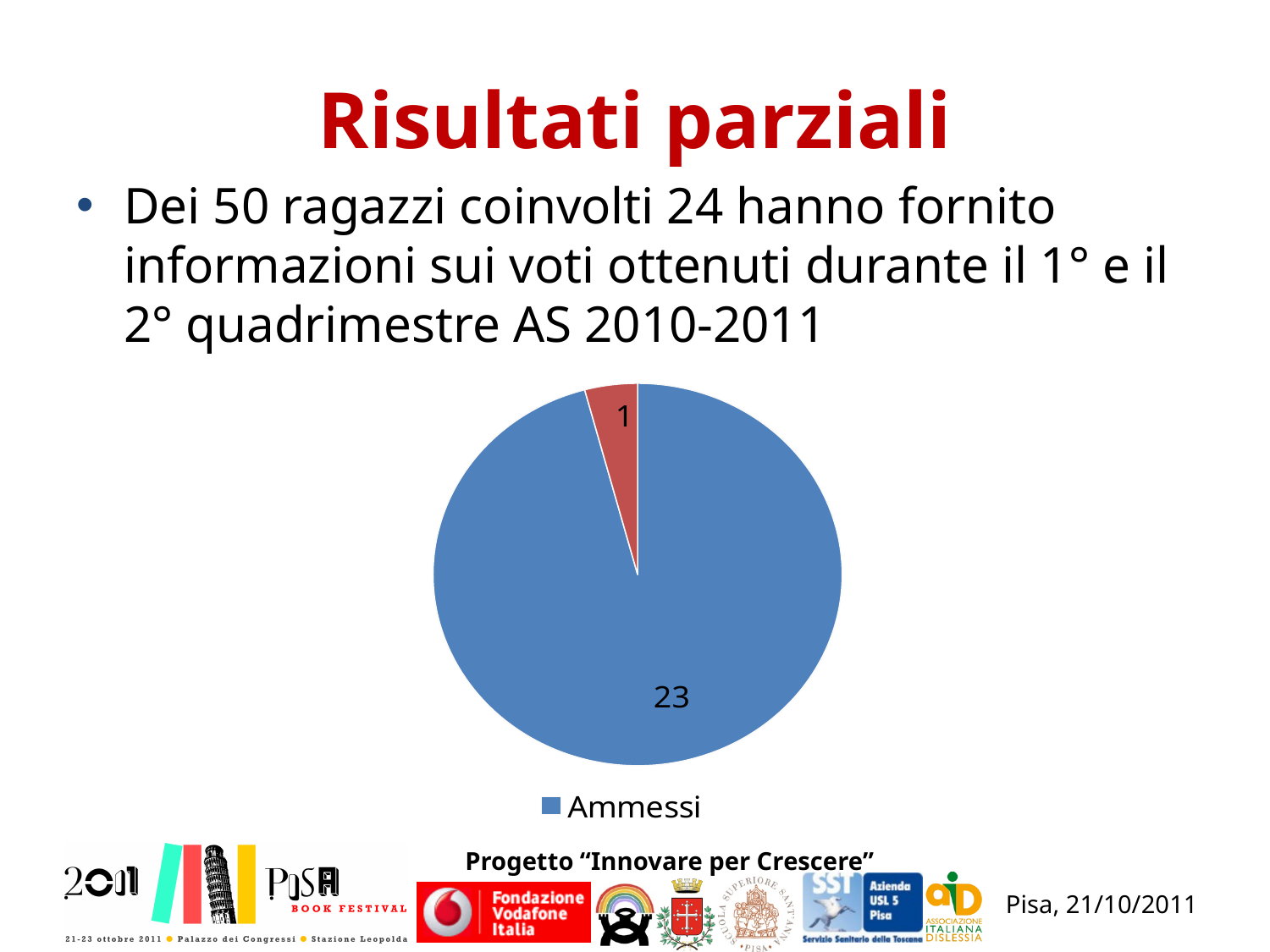
What kind of chart is shown on the slide? pie chart What colour is the Ammessi slice in the pie chart? blue How many slices does the pie chart have? 2 What value is shown on the small red slice of the pie chart? 1 What is the difference between the Ammessi slice and the red slice in the pie chart? 22 Which is larger in the pie chart, the blue Ammessi slice or the red slice? the blue Ammessi slice Which slice of the pie chart is the smallest? the red slice (1) What value is shown for the Ammessi slice of the pie chart? 23 What is the only entry shown in the legend of the pie chart? Ammessi What is the total of the two values shown in the pie chart? 24 Which slice of the pie chart is the largest? Ammessi How many entries does the legend of the pie chart list? 1